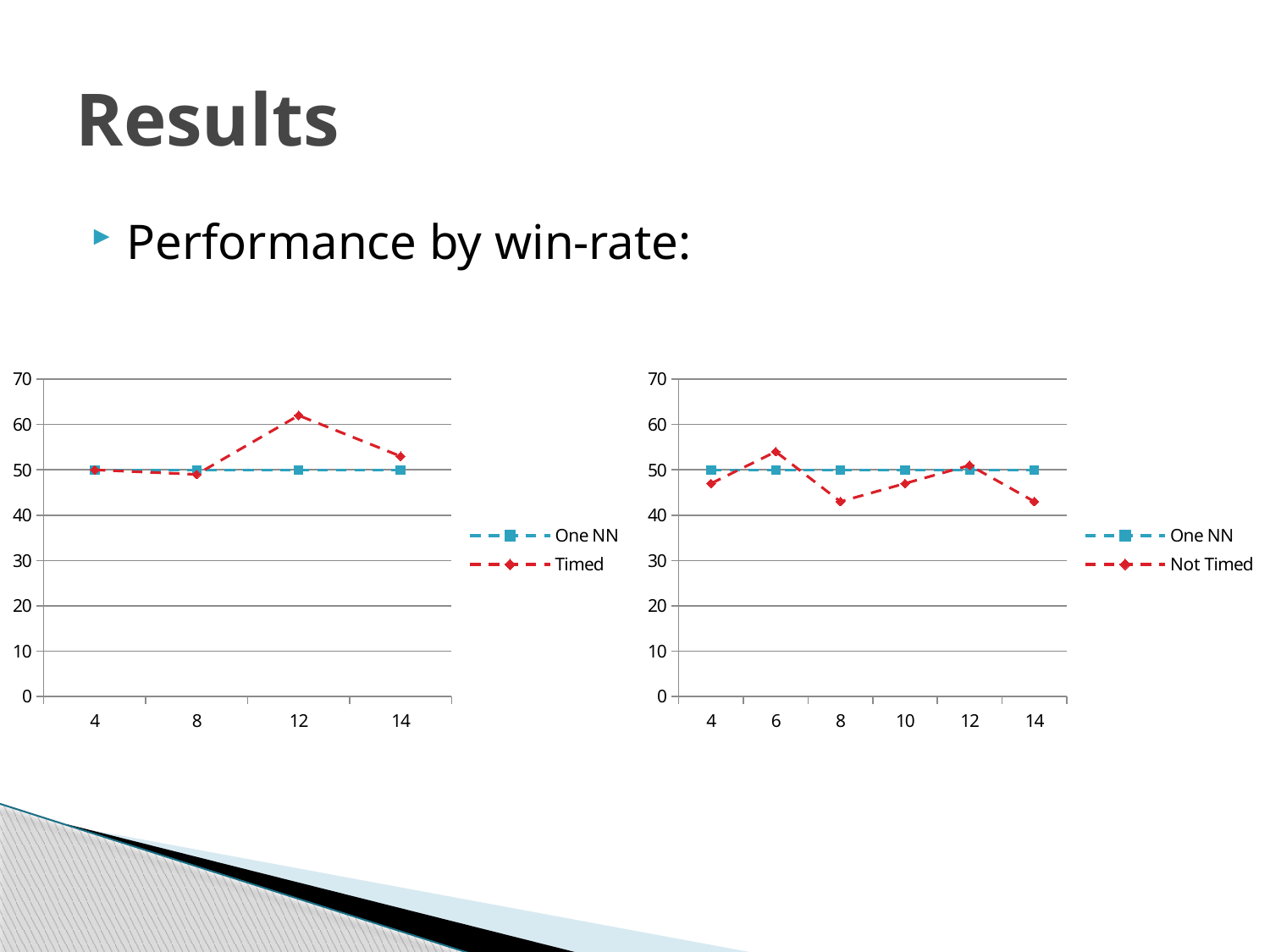
Which two series are listed in the legend of the right chart? One NN and Not Timed What kind of chart is the left chart? line chart In the right chart, is the value for Not Timed at 6 greater or less than 50? greater In the left chart, what is the value of One NN at 4? 50 How many x-axis categories does the left chart have? 4 How many series does the legend of the left chart list? 2 In the right chart, at which x value does the Not Timed series reach its highest point? 6 In the right chart, is the value for Not Timed at 8 greater or less than 50? less In the left chart, is the value for Timed at 12 greater or less than 60? greater In the left chart, at which x value does the Timed series reach its highest point? 12 In the left chart, which series has the larger value at 12, One NN or Timed? Timed How many points are plotted along the x axis of the right chart? 6